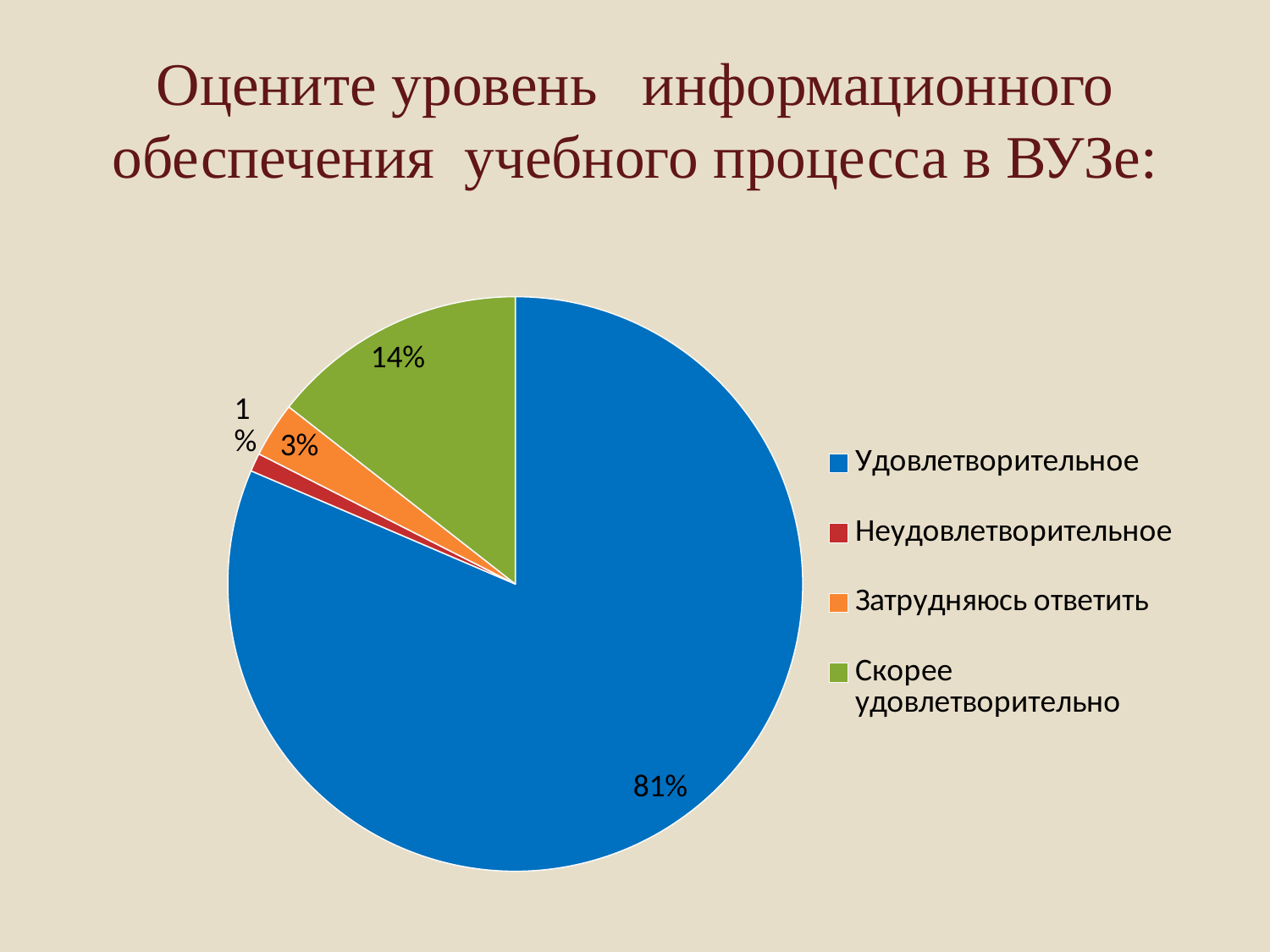
What kind of chart is shown on the slide? pie chart What share of the pie is labelled "Удовлетворительное"? 81% What share of the pie is labelled "Неудовлетворительное"? 1% What share of the pie is labelled "Затрудняюсь ответить"? 3% Which category has the smallest slice of the pie? Неудовлетворительное Which is larger: the share for "Затрудняюсь ответить" or the share for "Скорее удовлетворительно"? Скорее удовлетворительно What is the difference in percentage points between "Удовлетворительное" and "Скорее удовлетворительно"? 67 How many slices does the pie chart have? 4 Which category has the largest slice of the pie? Удовлетворительное What colour is the slice for "Скорее удовлетворительно"? green How many entries does the legend list? 4